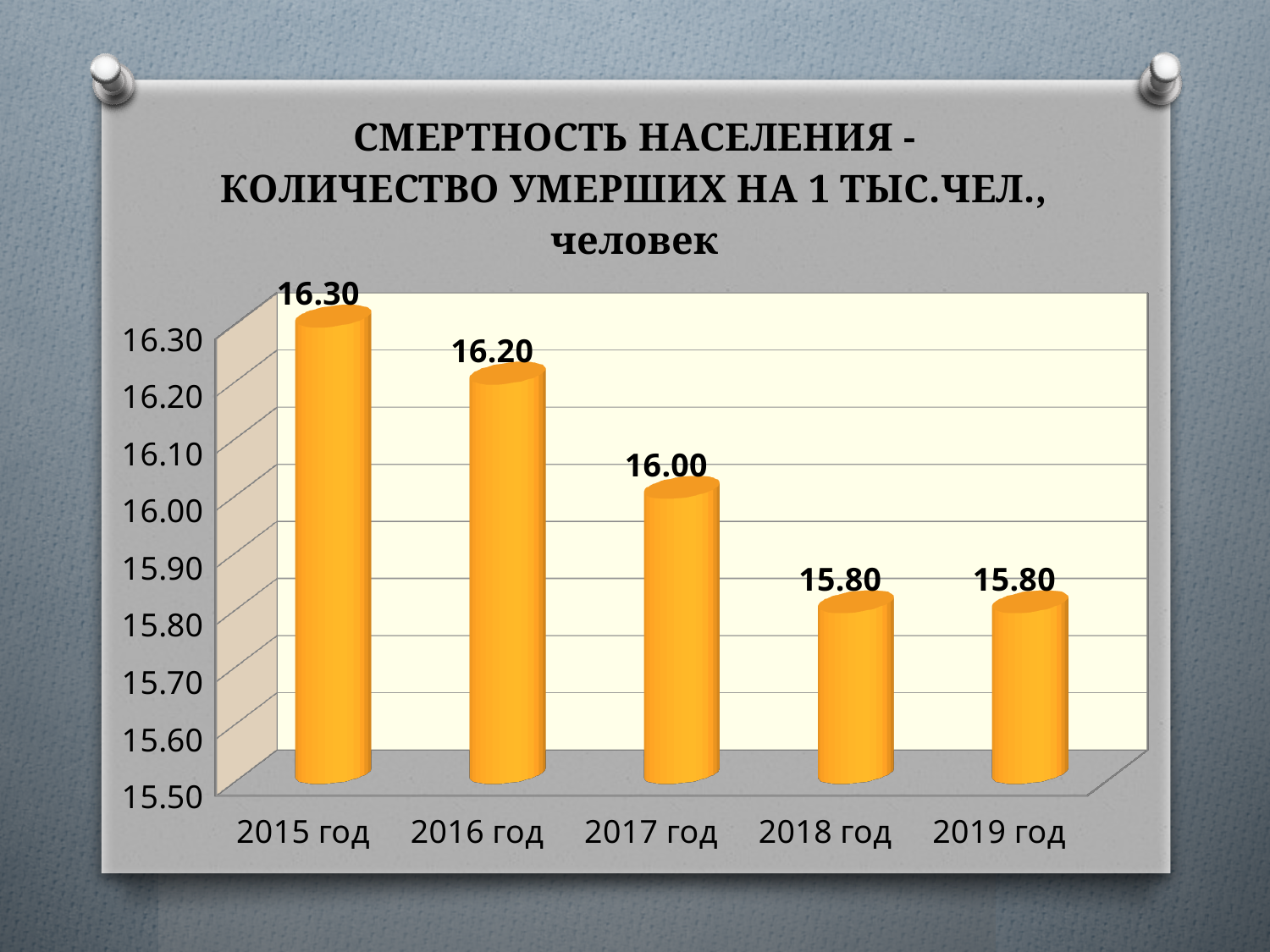
What is the difference between the values for 2015 год and 2019 год? 0.50 How many years are shown on the chart? 5 Is the value for 2017 год greater or less than 16.10? less What is the value for 2019 год? 15.80 Do the values rise or fall from 2015 год to 2019 год? fall What is the difference between the values for 2016 год and 2017 год? 0.20 Which year has the highest value? 2015 год What is the title of the chart? СМЕРТНОСТЬ НАСЕЛЕНИЯ - КОЛИЧЕСТВО УМЕРШИХ НА 1 ТЫС.ЧЕЛ., человек What is the value for 2017 год? 16.00 What kind of chart is shown on the slide? bar chart Which is larger, the value for 2016 год or the value for 2018 год? 2016 год What is the value for 2015 год? 16.30